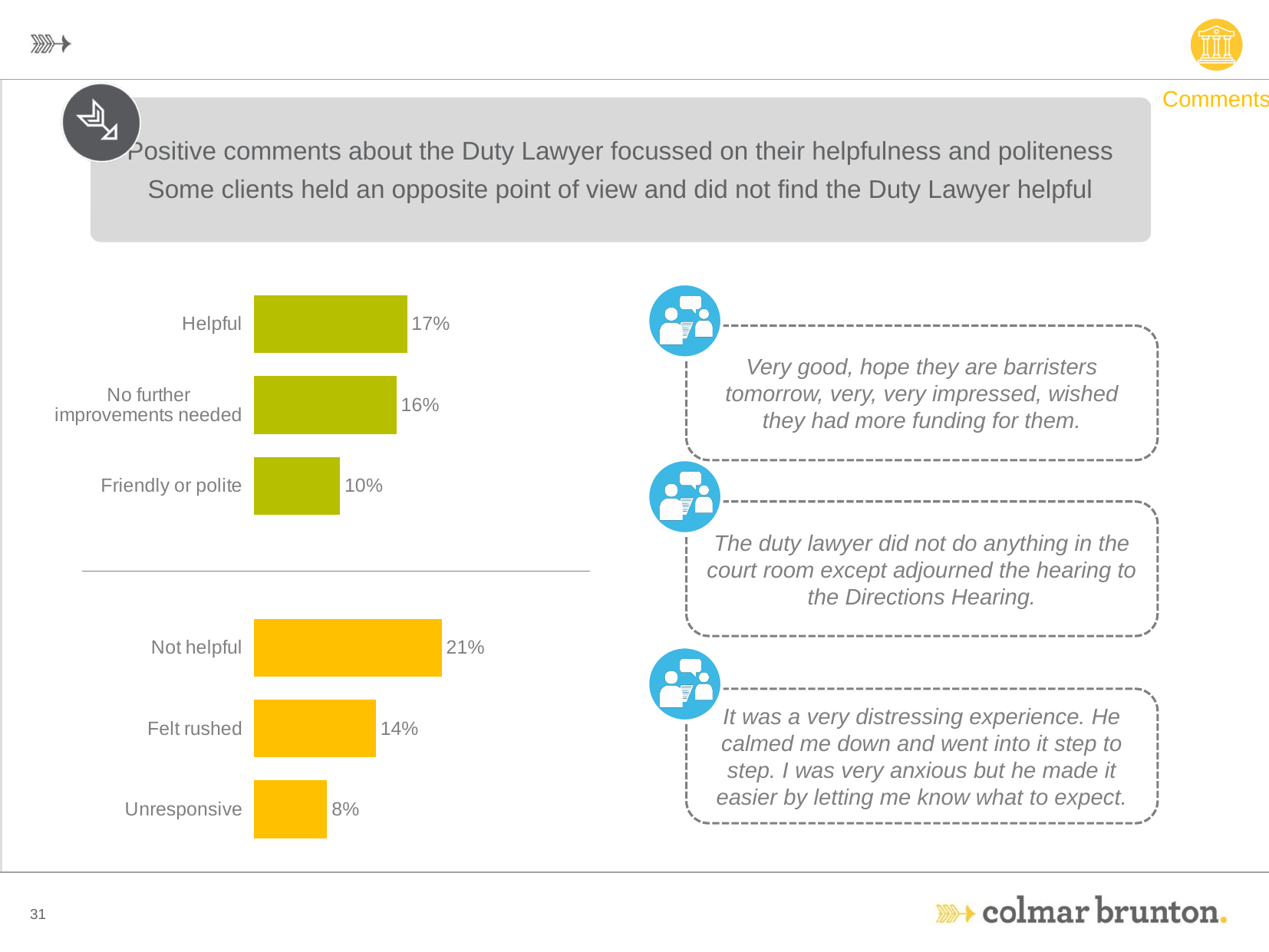
Which is larger: the value for "Helpful" in the upper chart or the value for "Not helpful" in the lower chart? Not helpful In the lower bar chart, what percentage is shown for "Unresponsive"? 8% In the lower bar chart, what percentage is shown for "Not helpful"? 21% In the lower bar chart, which category has the highest value? Not helpful In the upper bar chart, what percentage is shown for "No further improvements needed"? 16% In the upper bar chart, what percentage is shown for "Helpful"? 17% What type of chart is used on the left side of the slide? Bar chart In the lower bar chart, what is the difference between the values for "Not helpful" and "Unresponsive"? 13% How many categories are shown in the upper bar chart? 3 In the upper bar chart, which category has the lowest value? Friendly or polite In the upper bar chart, what percentage is shown for "Friendly or polite"? 10% In the lower bar chart, what percentage is shown for "Felt rushed"? 14%